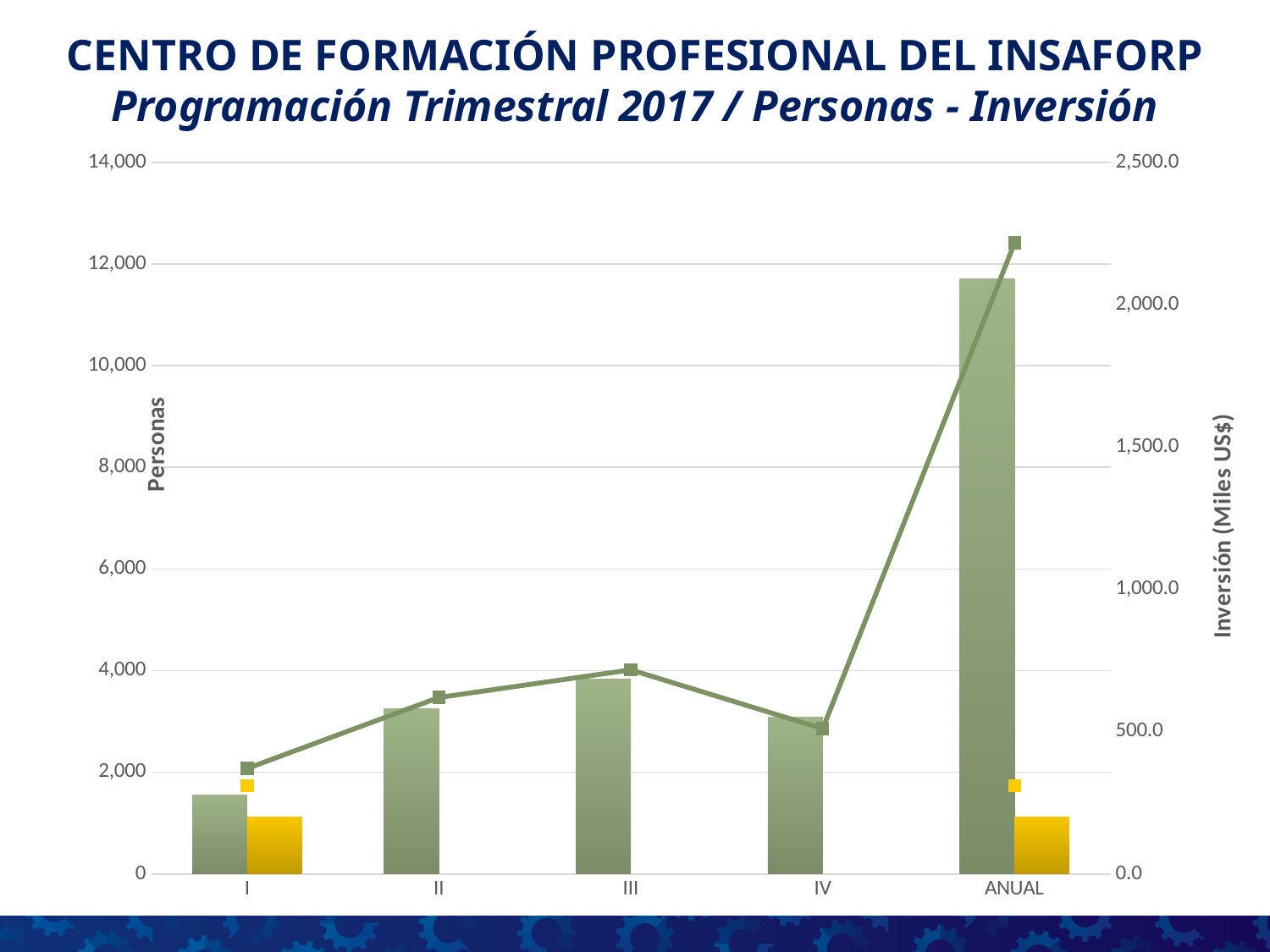
Among the quarters I to IV, which has the tallest green bar? III Is the green bar for I greater or less than 2,000 on the left axis? less Which category has the shortest green bar? I Which is higher on the green line, the point for III or the point for IV? III Is the green bar for ANUAL greater or less than 10,000 on the left axis? greater Is the green line point for ANUAL greater or less than 2,000.0 on the right axis? greater Which category has the tallest green bar? ANUAL How many categories are shown on the x axis? 5 What kind of chart is shown on the slide? A bar chart combined with a line chart What is the title of the right-hand vertical axis? Inversión (Miles US$)